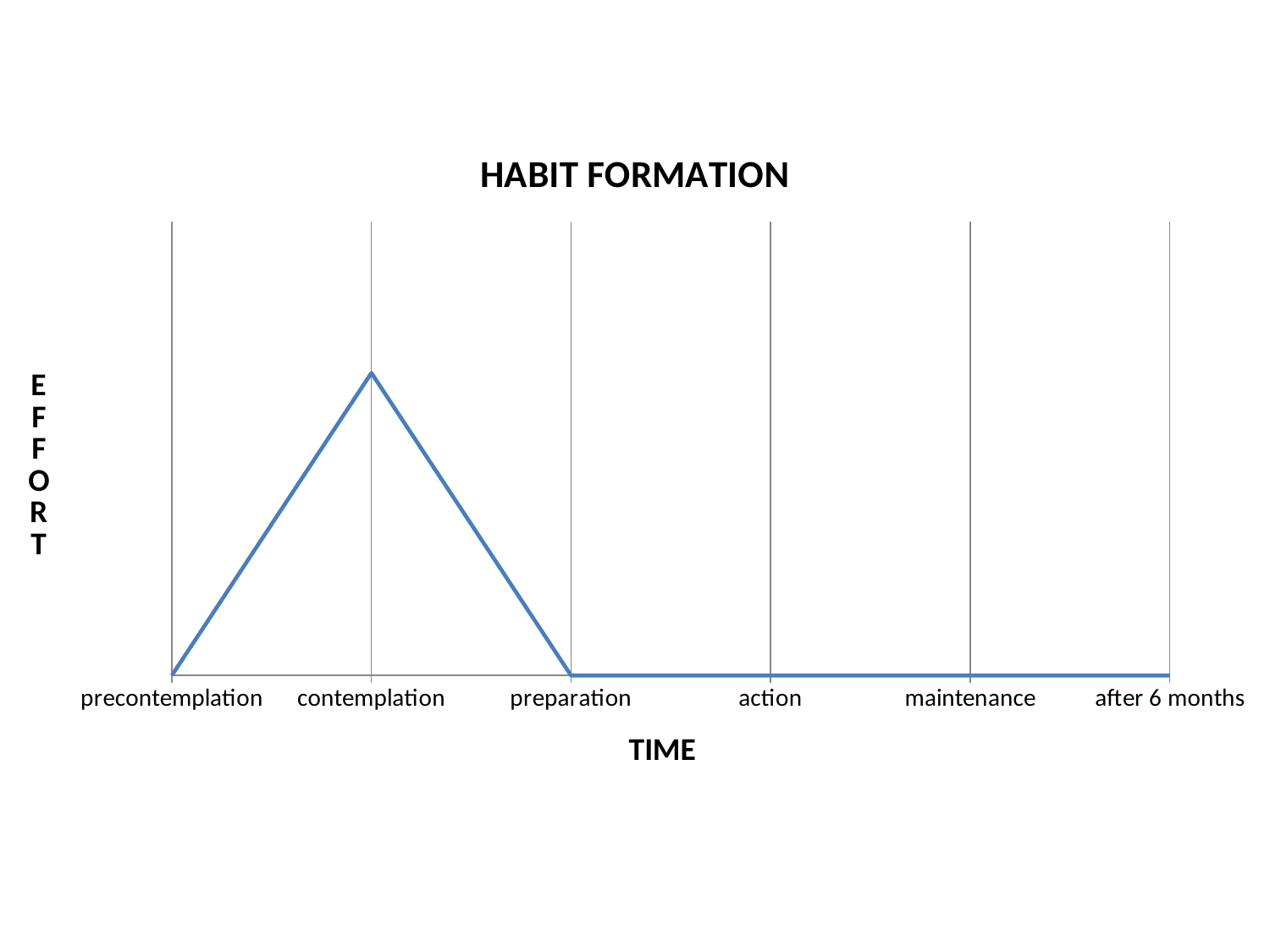
Does the effort value rise, fall or stay flat from preparation to after 6 months? stay flat What is the title of the chart? HABIT FORMATION How many categories are shown along the x axis? 6 What is the label of the x axis? TIME Which is larger, the effort value for contemplation or for action? contemplation What kind of chart is shown on the slide? line chart Does the effort value rise or fall from contemplation to preparation? fall Which is larger, the effort value for contemplation or for precontemplation? contemplation What is the last category on the x axis? after 6 months Does the effort value rise or fall from precontemplation to contemplation? rise Which category has the highest effort value? contemplation